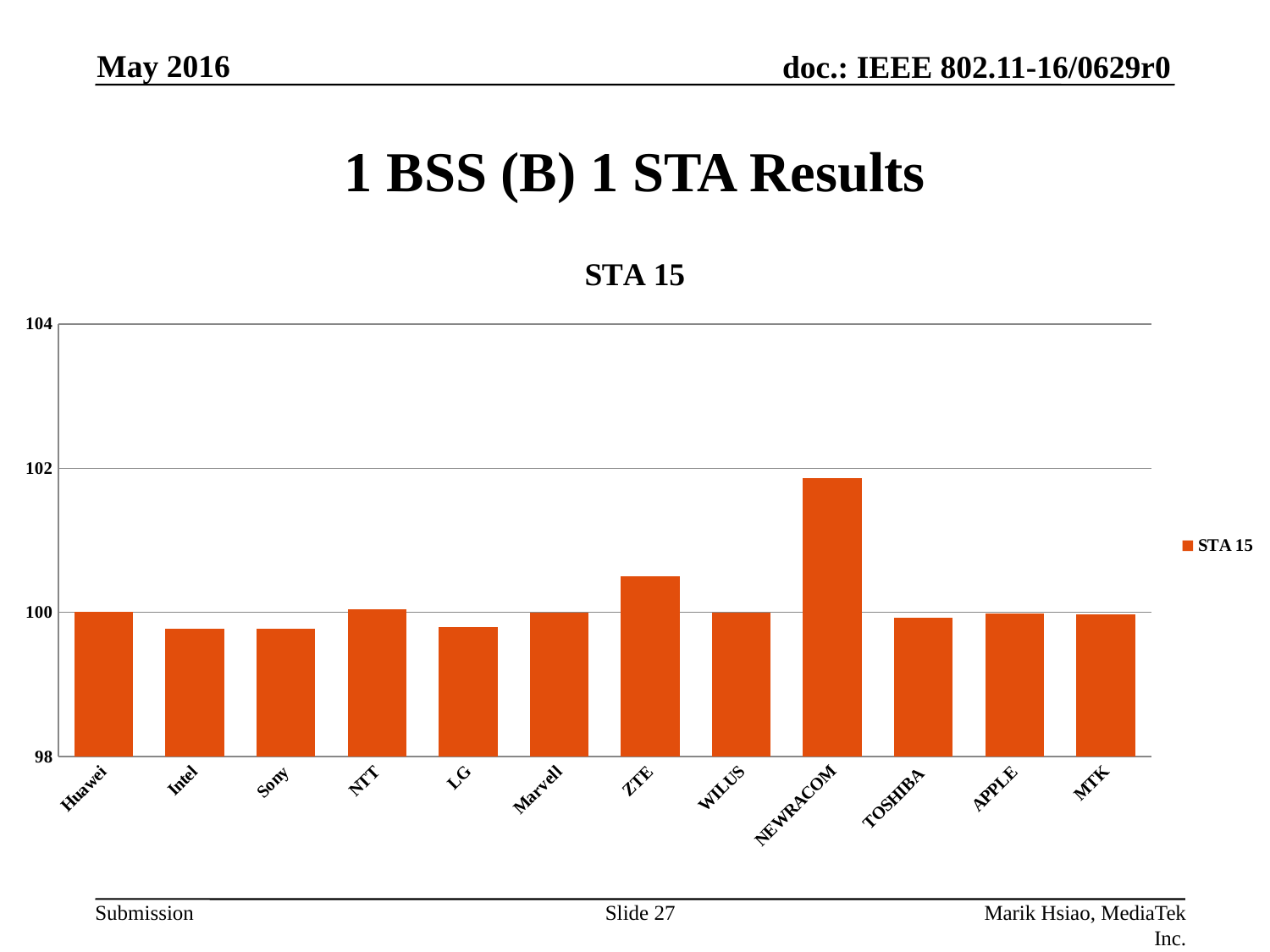
Is the value for Intel greater or less than 100? less What is the title of the chart? STA 15 Is the value for NEWRACOM greater or less than 100? greater Which has the larger value, NEWRACOM or ZTE? NEWRACOM Which category has the highest value in the chart? NEWRACOM Which has the larger value, ZTE or Intel? ZTE How many categories (companies) are shown on the x axis of the chart? 12 Is the value for Sony greater or less than 102? less How many series does the chart's legend list? 1 What kind of chart is shown on the slide? bar chart What is the name of the series listed in the chart's legend? STA 15